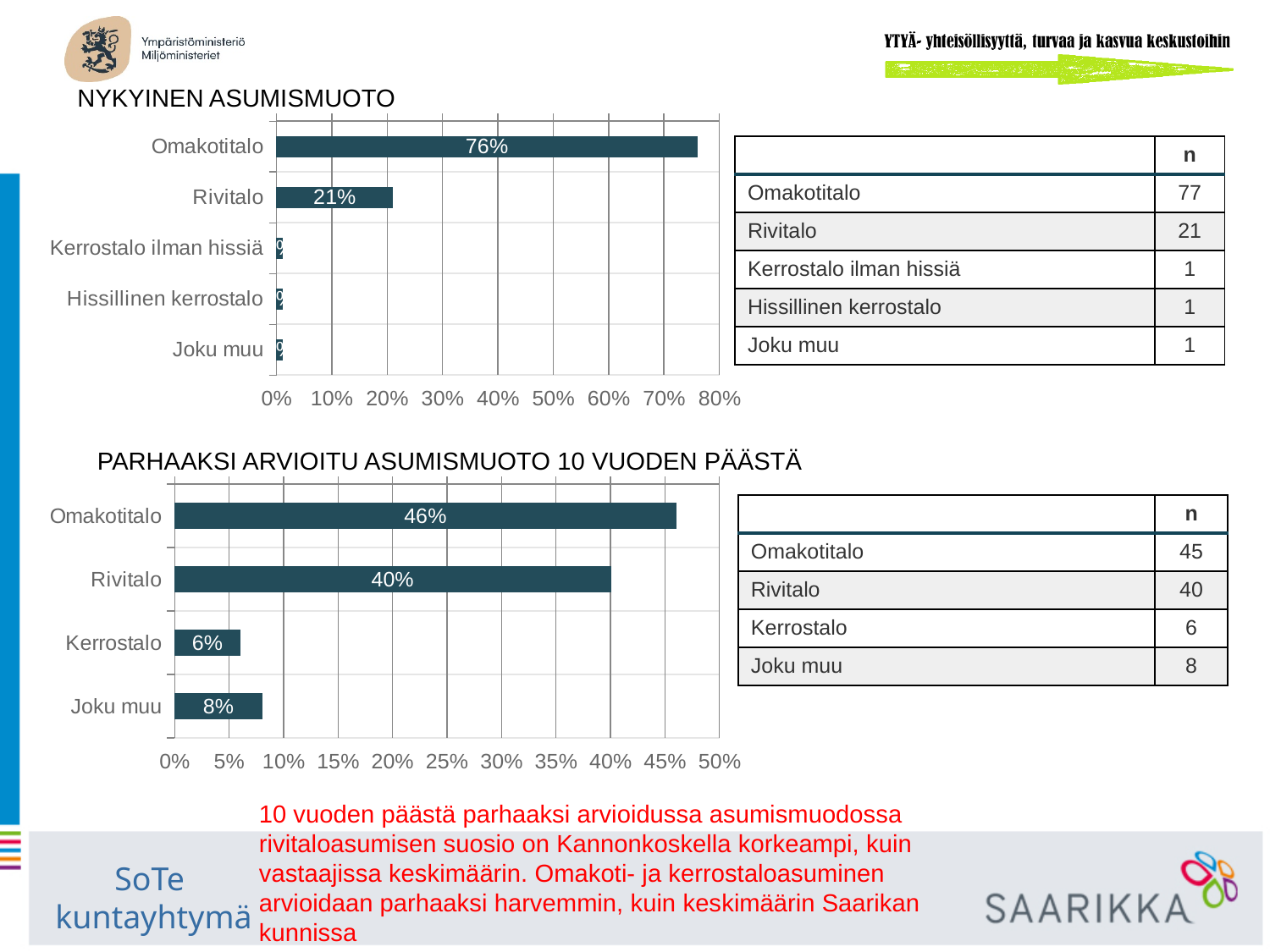
In the PARHAAKSI ARVIOITU ASUMISMUOTO 10 VUODEN PÄÄSTÄ chart, which category has the lowest value? Kerrostalo In the PARHAAKSI ARVIOITU ASUMISMUOTO 10 VUODEN PÄÄSTÄ chart, which is larger, Joku muu or Kerrostalo? Joku muu In the PARHAAKSI ARVIOITU ASUMISMUOTO 10 VUODEN PÄÄSTÄ chart, what is the difference between Omakotitalo and Rivitalo? 6% In the NYKYINEN ASUMISMUOTO chart, is the value for Rivitalo greater or less than 30%? less In the PARHAAKSI ARVIOITU ASUMISMUOTO 10 VUODEN PÄÄSTÄ chart, what is the value for Kerrostalo? 6% What type of chart is the PARHAAKSI ARVIOITU ASUMISMUOTO 10 VUODEN PÄÄSTÄ chart? Bar chart In the NYKYINEN ASUMISMUOTO chart, what is the value for Rivitalo? 21% In the NYKYINEN ASUMISMUOTO chart, what is the difference between Omakotitalo and Rivitalo? 55% In the NYKYINEN ASUMISMUOTO chart, which category has the highest value? Omakotitalo In the NYKYINEN ASUMISMUOTO chart, what is the value for Omakotitalo? 76% In the PARHAAKSI ARVIOITU ASUMISMUOTO 10 VUODEN PÄÄSTÄ chart, what is the value for Rivitalo? 40% How many categories are shown in the NYKYINEN ASUMISMUOTO chart? 5